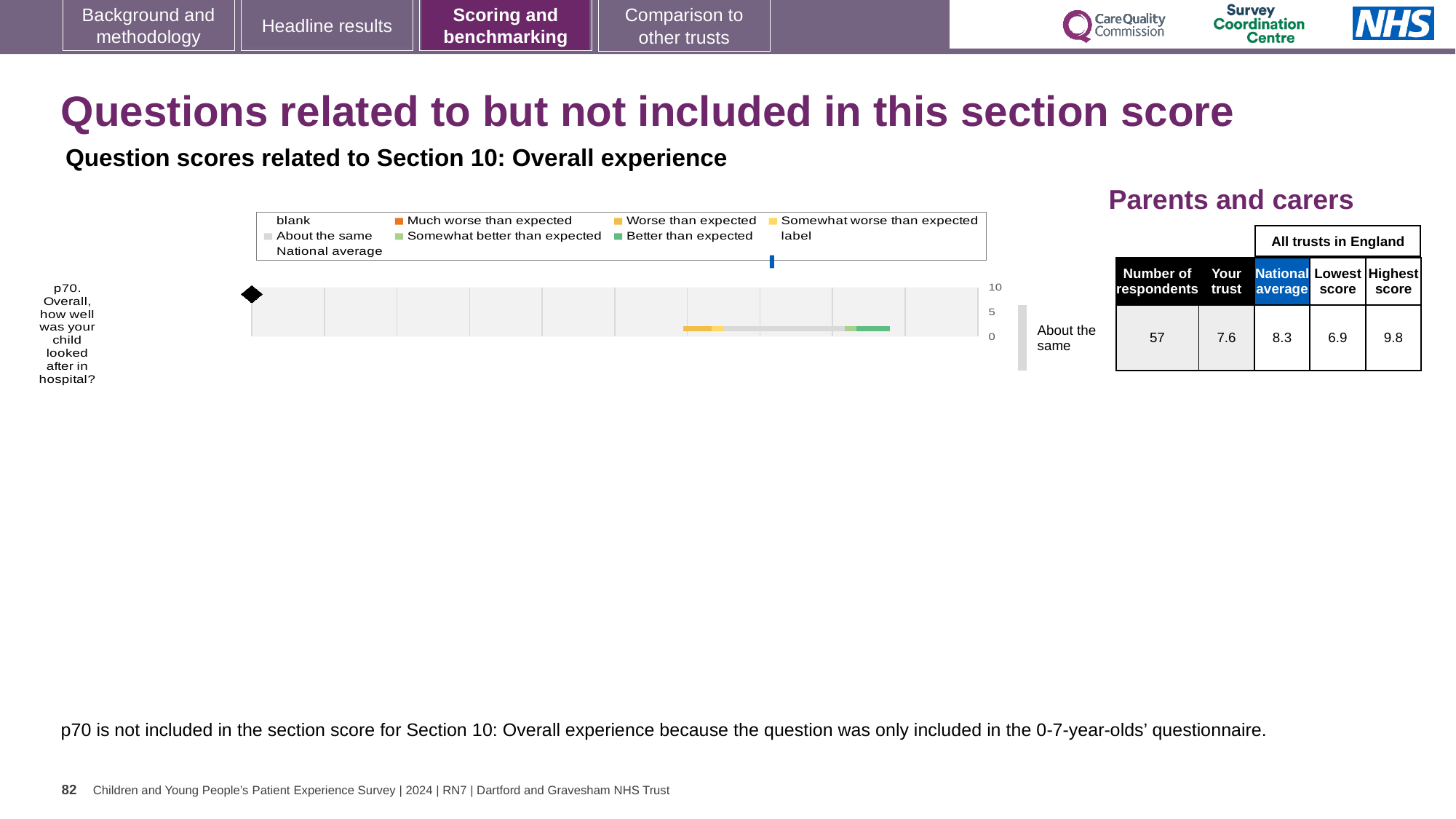
How many questions are plotted in the chart? 1 How many entries does the chart legend list? 9 What is the lowest score among all trusts in England for p70? 6.9 What is the national average score for p70? 8.3 How many respondents answered p70 for this trust? 57 Which is larger for p70: the trust's score or the national average? National average What is the difference between the national average and the trust's score for p70? 0.7 What is the 'Your trust' score for p70 (Overall, how well was your child looked after in hospital?)? 7.6 What is the difference between the highest and lowest scores for p70 across all trusts in England? 2.9 Which benchmarking category is the trust's p70 result placed in? About the same What kind of chart is used to show the p70 question score? bar chart What is the highest score among all trusts in England for p70? 9.8